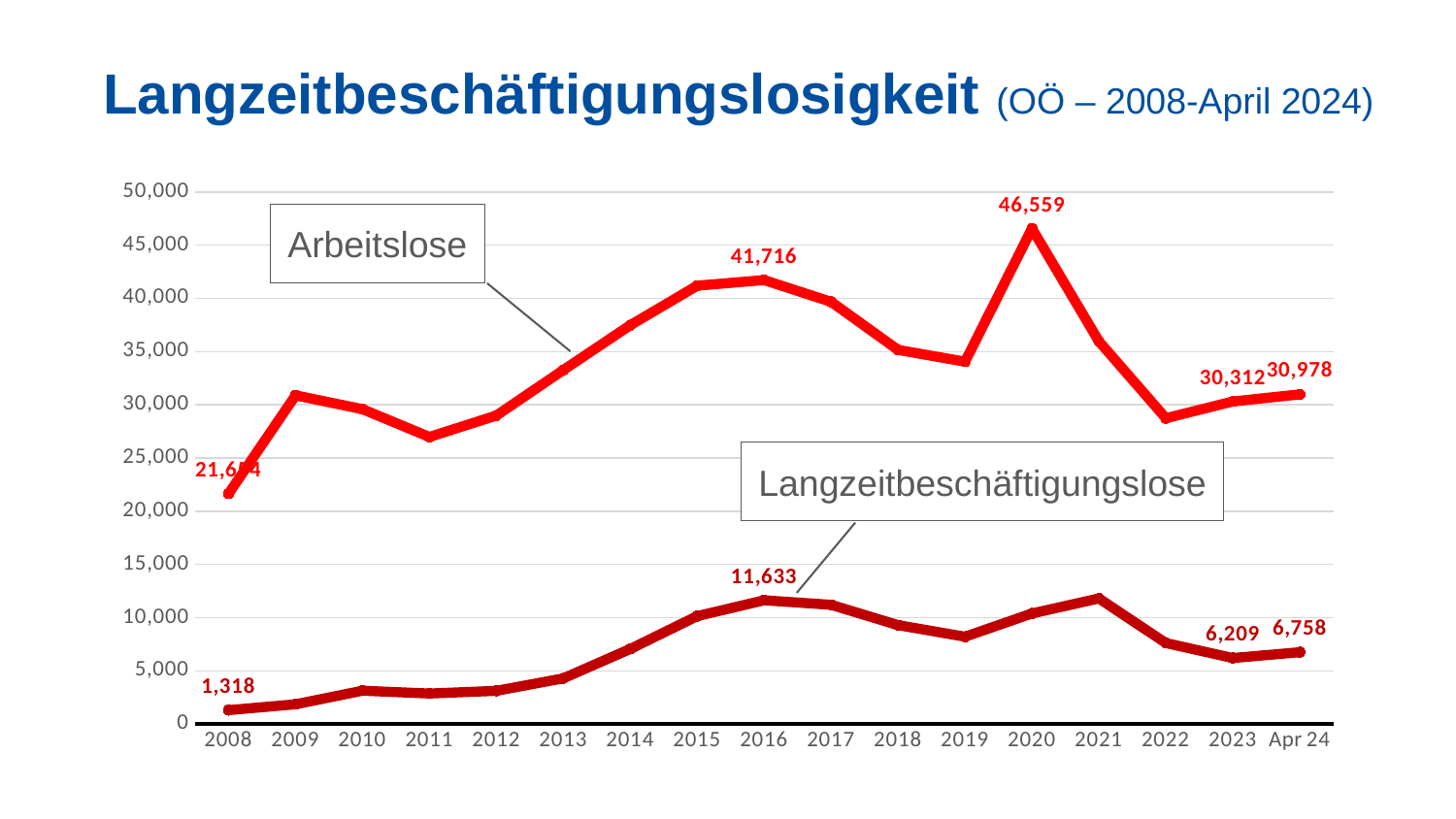
Is the value for Langzeitbeschäftigungslose in 2021 greater or less than 10,000? greater How many time points are shown on the x axis? 17 Which is larger for Arbeitslose: the value in 2016 or in Apr 24? 2016 What is the value for Langzeitbeschäftigungslose in 2016? 11,633 What kind of chart is shown on the slide? line chart In which year does the Arbeitslose series reach its highest value? 2020 In which year is the Langzeitbeschäftigungslose series at its lowest? 2008 What is the difference between the Arbeitslose values in 2020 and 2016? 4,843 By how much did Langzeitbeschäftigungslose change from 2023 to Apr 24? 549 What is the value for Arbeitslose in Apr 24? 30,978 What is the value for Arbeitslose in 2020? 46,559 Is the value for Arbeitslose in 2011 greater or less than 30,000? less